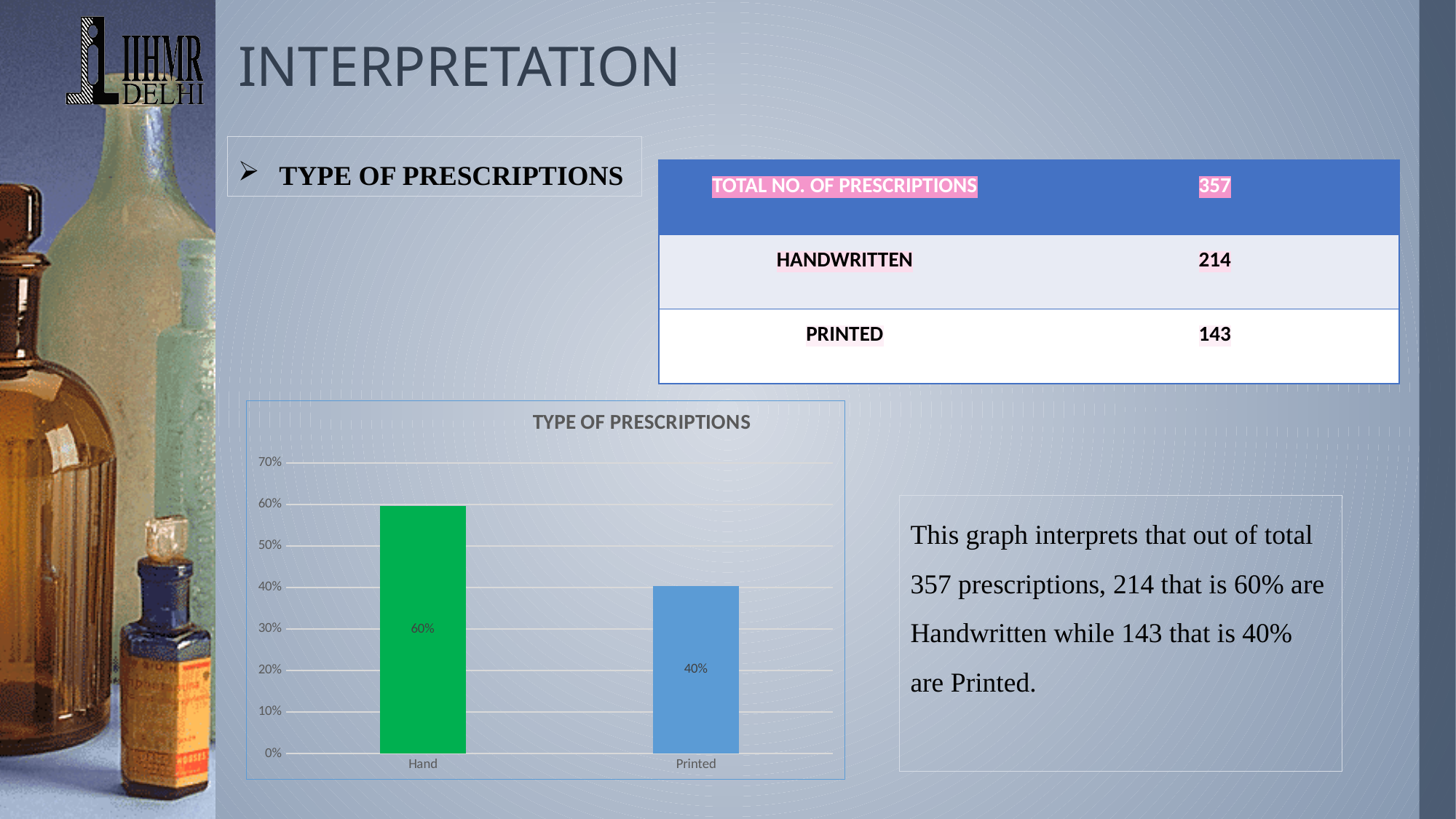
What kind of chart is shown on the slide? bar chart How many categories are shown in the chart? 2 Is the value for Hand greater or less than 50%? greater Is the value for Printed greater or less than 50%? less What is the value for Hand in the chart? 60% What is the value for Printed in the chart? 40% Which is larger, the value for Hand or the value for Printed? Hand Which category has the highest value in the chart? Hand What is the difference between the values for Hand and Printed? 20% What is the title of the chart? TYPE OF PRESCRIPTIONS Which category has the lowest value in the chart? Printed What colour is the bar for Hand? green